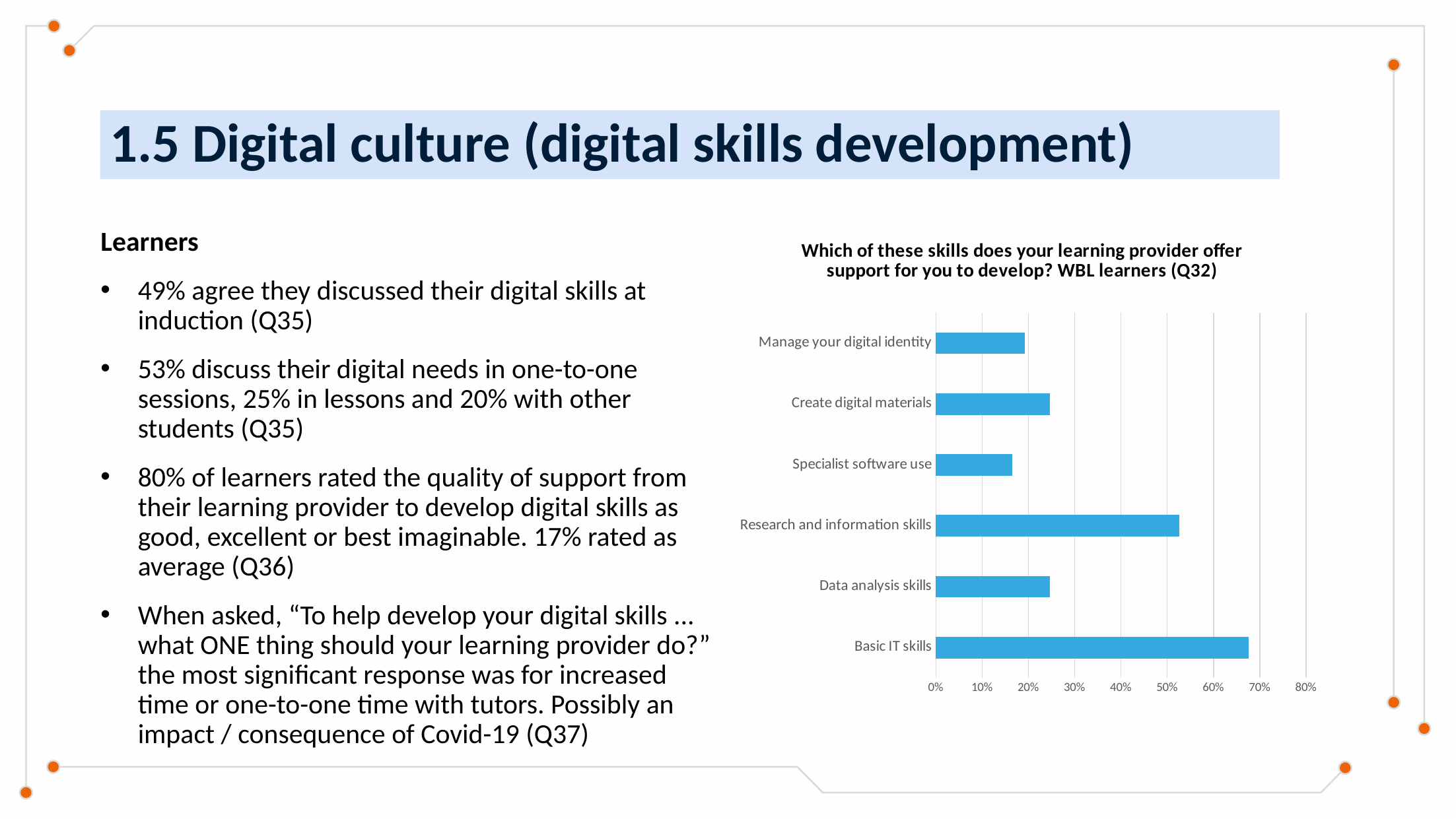
How many skill categories are plotted in the chart? 6 Is the value for Data analysis skills greater or less than 40%? less Is the value for Create digital materials greater or less than 10%? greater Which is larger, the value for Research and information skills or the value for Specialist software use? Research and information skills Which is larger, the value for Basic IT skills or the value for Research and information skills? Basic IT skills Is the value for Basic IT skills greater or less than 60%? greater What kind of chart is shown on the slide? bar chart Which skill has the highest percentage in the chart? Basic IT skills What is the title of the chart? Which of these skills does your learning provider offer support for you to develop? WBL learners (Q32)